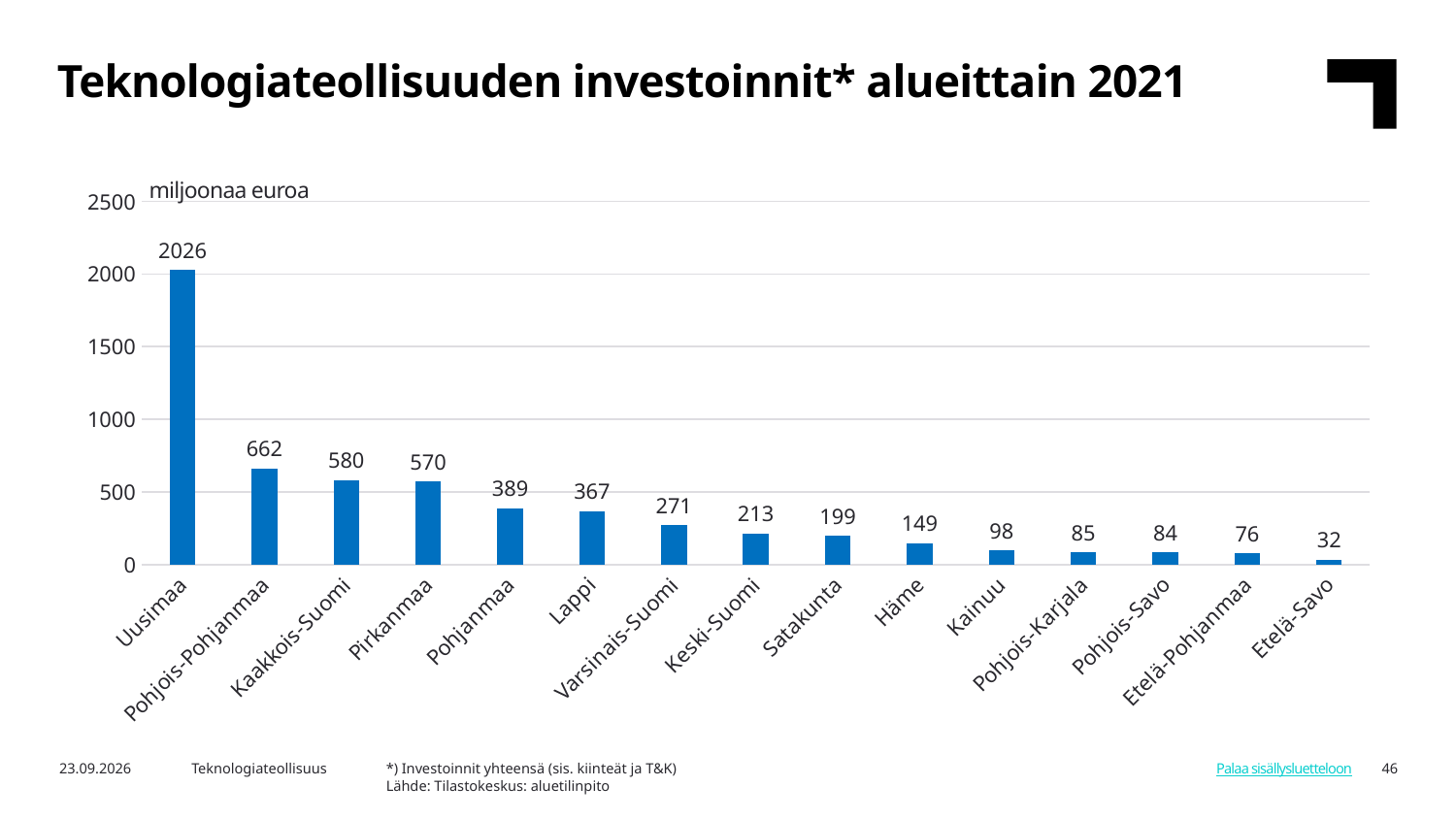
How many regions are shown in the chart? 15 What is the difference between the values for Uusimaa and Pirkanmaa? 1456 What is the investment value for Satakunta? 199 What is the difference between the values for Pohjois-Pohjanmaa and Kaakkois-Suomi? 82 What unit is shown above the vertical axis of the chart? miljoonaa euroa Which region has the highest investment value? Uusimaa Is the value for Häme greater or less than 500? less What is the investment value for Uusimaa? 2026 Which has a larger value, Pohjanmaa or Varsinais-Suomi? Pohjanmaa What kind of chart is shown on the slide? bar chart What is the investment value for Lappi? 367 Which region has the lowest investment value? Etelä-Savo